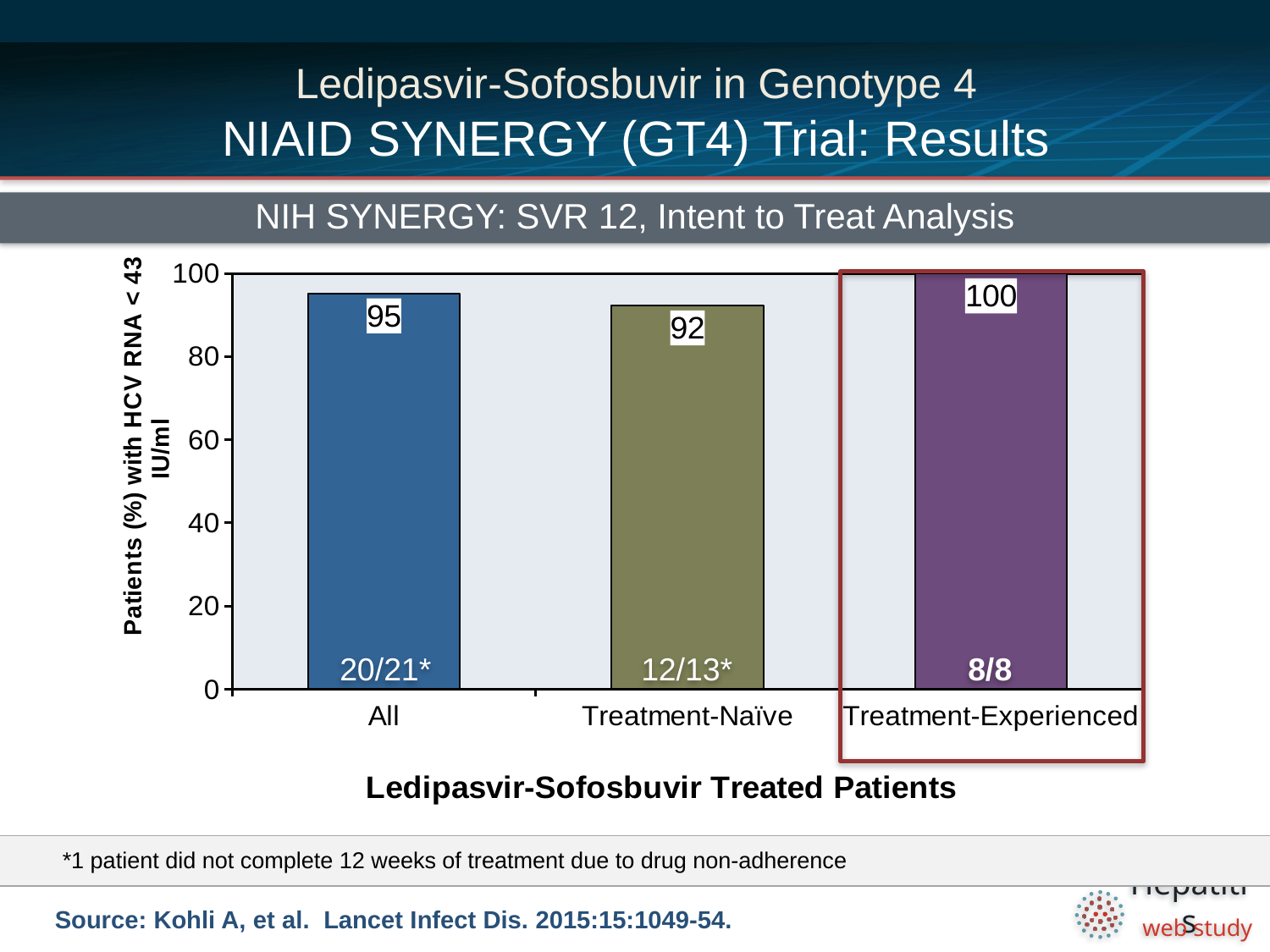
What is the SVR 12 value for the All group? 95 What kind of chart is shown on the slide? Bar chart What is the title of the x axis? Ledipasvir-Sofosbuvir Treated Patients Which group has the highest SVR 12 value? Treatment-Experienced What is the difference between the SVR 12 values for Treatment-Experienced and Treatment-Naïve? 8 How many patient groups are shown on the x axis? 3 Which group has the lowest SVR 12 value? Treatment-Naïve What is the SVR 12 value for the Treatment-Experienced group? 100 What is the SVR 12 value for the Treatment-Naïve group? 92 What fraction of patients is printed on the bar for the All group? 20/21* Which group has a larger SVR 12 value, All or Treatment-Naïve? All What fraction of patients is printed on the bar for the Treatment-Experienced group? 8/8